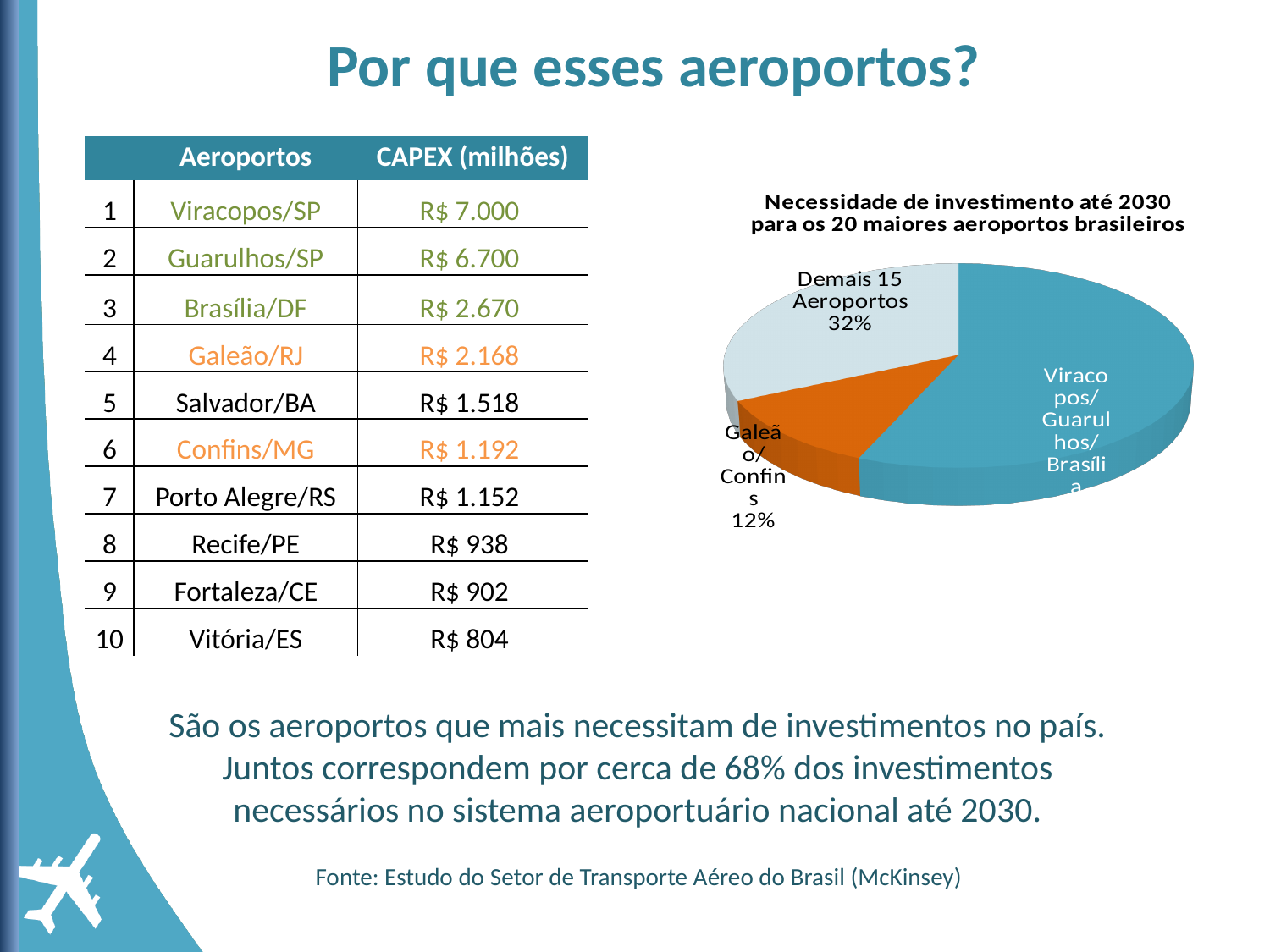
Which slice of the pie chart is the smallest? Galeão/Confins How many slices does the pie chart have? 3 What is the difference in percentage points between the 'Demais 15 Aeroportos' slice and the 'Galeão/Confins' slice? 20 percentage points What share of the pie does the 'Galeão/Confins' slice represent? 12% Which slice is larger: 'Viracopos/Guarulhos/Brasília' or 'Demais 15 Aeroportos'? Viracopos/Guarulhos/Brasília Which slice is larger: 'Demais 15 Aeroportos' or 'Galeão/Confins'? Demais 15 Aeroportos What colour is the 'Galeão/Confins' slice in the pie chart? orange What kind of chart is shown on the slide? pie chart Which slice of the pie chart is the largest? Viracopos/Guarulhos/Brasília What is the title of the pie chart? Necessidade de investimento até 2030 para os 20 maiores aeroportos brasileiros What share of the pie does the 'Demais 15 Aeroportos' slice represent? 32%